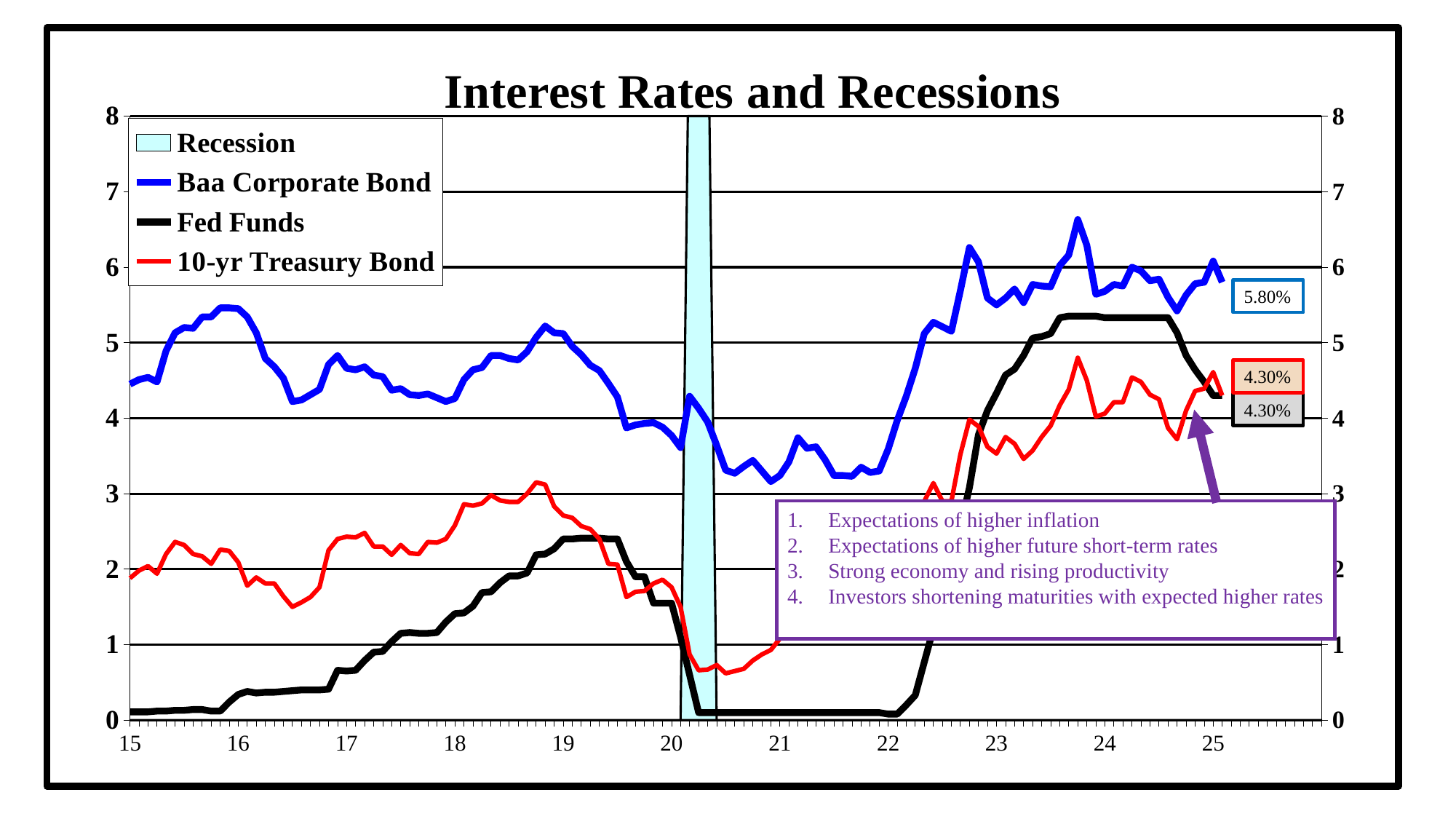
What is the latest labelled value for the 10-yr Treasury Bond series? 4.30% What is the latest labelled value for the Baa Corporate Bond series? 5.80% What is the title of the chart? Interest Rates and Recessions What is the difference between the latest labelled Baa Corporate Bond value and the latest labelled Fed Funds value? 1.50% Is the Fed Funds rate during 2021 greater or less than 1? less What is the latest labelled value for the Fed Funds series? 4.30% Does the Fed Funds rate rise or fall between 2022 and 2023? Rises What kind of chart is shown on the slide? Line chart Is the Baa Corporate Bond rate at the start of 2016 greater or less than 5? greater How many entries does the chart's legend list? 4 What colour is the line for the Baa Corporate Bond series? Blue At the end of the chart, which series has the highest labelled value? Baa Corporate Bond